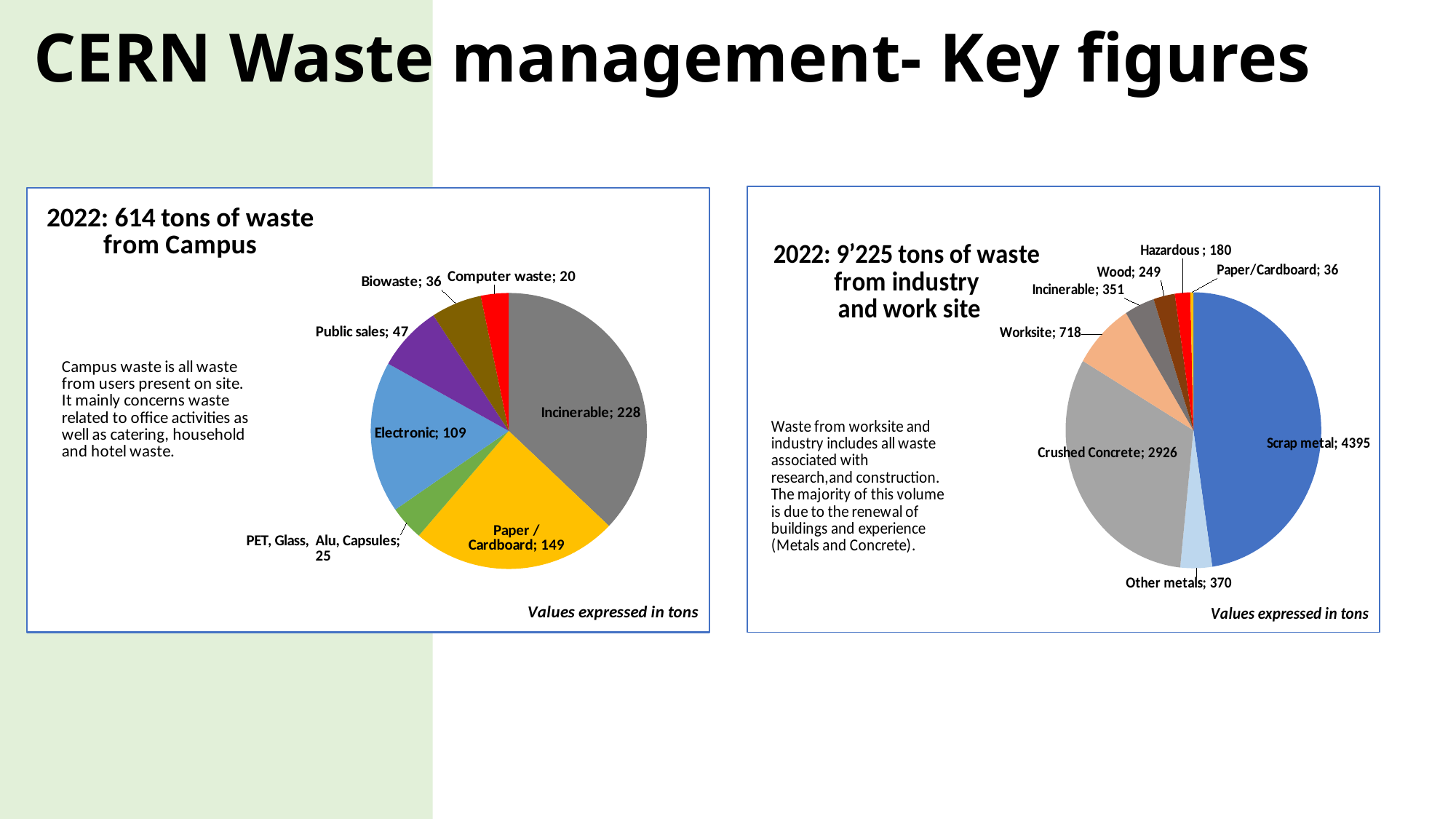
How many categories are shown in the campus waste pie chart (left)? 7 In the industry and work site pie chart (right), which category has the smallest slice? Paper/Cardboard What type of chart is used on the left side of the slide for campus waste? Pie chart According to the note under each chart, in what unit are the values expressed? Tons In the campus waste pie chart (left), which category has the smallest slice? Computer waste How many categories are shown in the industry and work site pie chart (right)? 8 In the campus waste pie chart (left), which category has the largest slice? Incinerable In the campus waste pie chart (left), which is larger: Electronic or Paper / Cardboard? Paper / Cardboard In the industry and work site pie chart (right), how many tons of Crushed Concrete are shown? 2926 In the campus waste pie chart (left), how many tons of Incinerable waste are shown? 228 In the industry and work site pie chart (right), which is larger: Wood or Incinerable? Incinerable In the industry and work site pie chart (right), what is the difference in tons between Scrap metal and Crushed Concrete? 1469